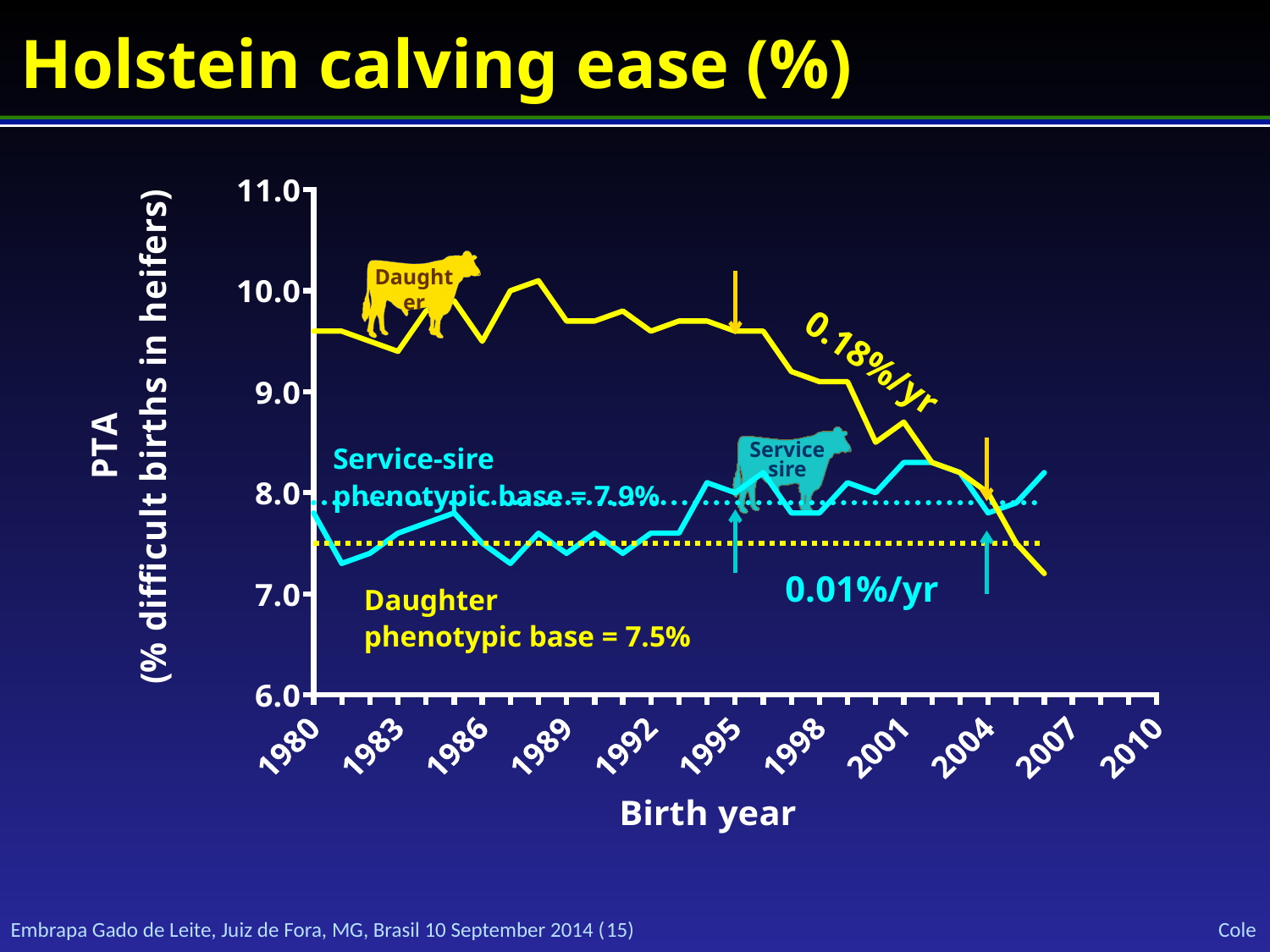
What annual rate of change is annotated on the Service sire line? 0.01%/yr What kind of chart is shown on the slide? line chart Is the Daughter value for 1980 greater or less than 9.0? greater Does the Daughter line rise or fall between 1995 and 2007? fall What annual rate of change is annotated on the Daughter line? 0.18%/yr What is the title of the chart? Holstein calving ease (%) What is the label of the x axis? Birth year What is the Daughter phenotypic base shown on the chart? 7.5% How many series are plotted on the chart? 4 What is the Service-sire phenotypic base shown on the chart? 7.9% At birth year 1989, which series has the higher value, Daughter or Service sire? Daughter